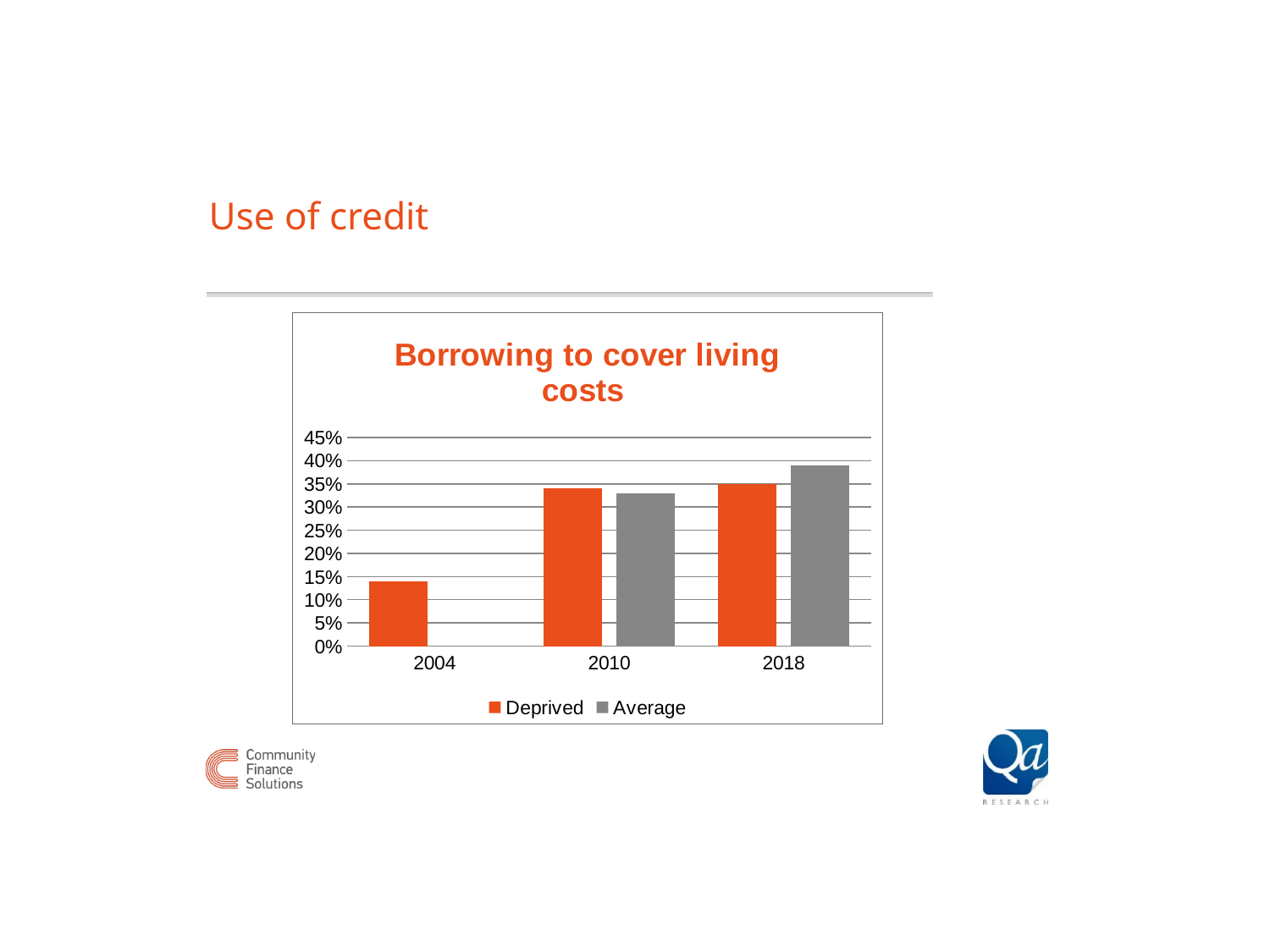
Is the Deprived value for 2018 greater or less than 40%? less What kind of chart is shown on the slide? Bar chart Which colour represents the Deprived series? Orange How many years are shown on the x axis? 3 What is the title of the chart? Borrowing to cover living costs How many series does the legend list? 2 In 2018, which is larger, the Deprived value or the Average value? Average Is the Deprived value for 2010 greater or less than 30%? greater In which year is the Deprived series lowest? 2004 In which year is the Average series highest? 2018 Is the Average value for 2018 greater or less than 35%? greater